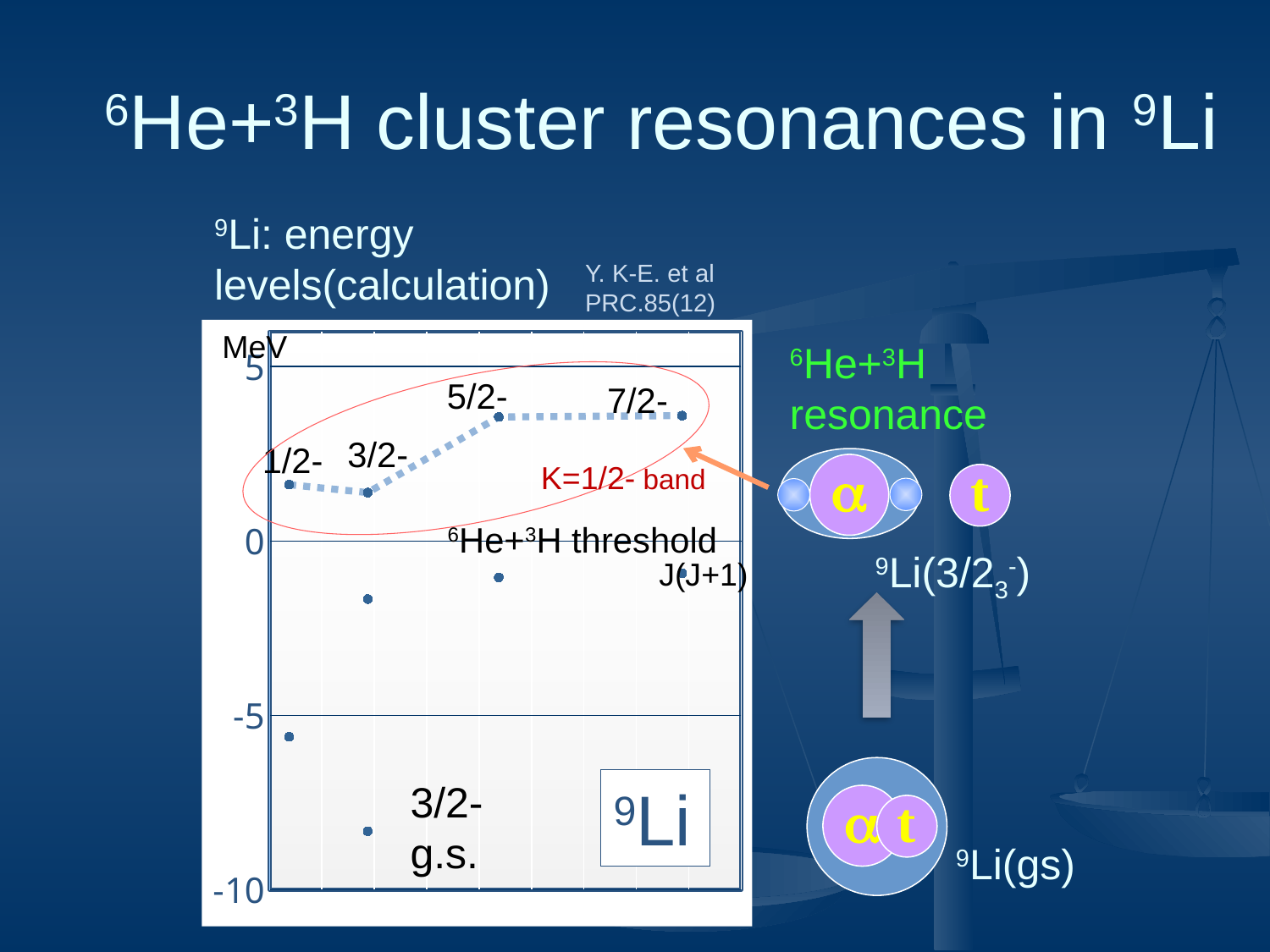
Which has the lower energy, the 7/2- state or the 3/2- g.s. state? 3/2- g.s. Is the energy of the 1/2- state in the K=1/2- band greater or less than 0 MeV? greater Is the energy of the 3/2- g.s. state greater or less than -5 MeV? less Is the energy of the 5/2- state greater or less than 5 MeV? less Which has the higher energy, the 5/2- state or the 3/2- state in the K=1/2- band? 5/2- What is the label on the horizontal axis of the chart? J(J+1) How many labeled states are enclosed in the K=1/2- band ellipse? 4 What unit is shown on the vertical axis of the chart? MeV Along the K=1/2- band, does the energy rise or fall from the 3/2- state to the 7/2- state? rise What kind of chart is shown on the slide? scatter chart Which labeled state on the chart has the lowest energy? 3/2- g.s.